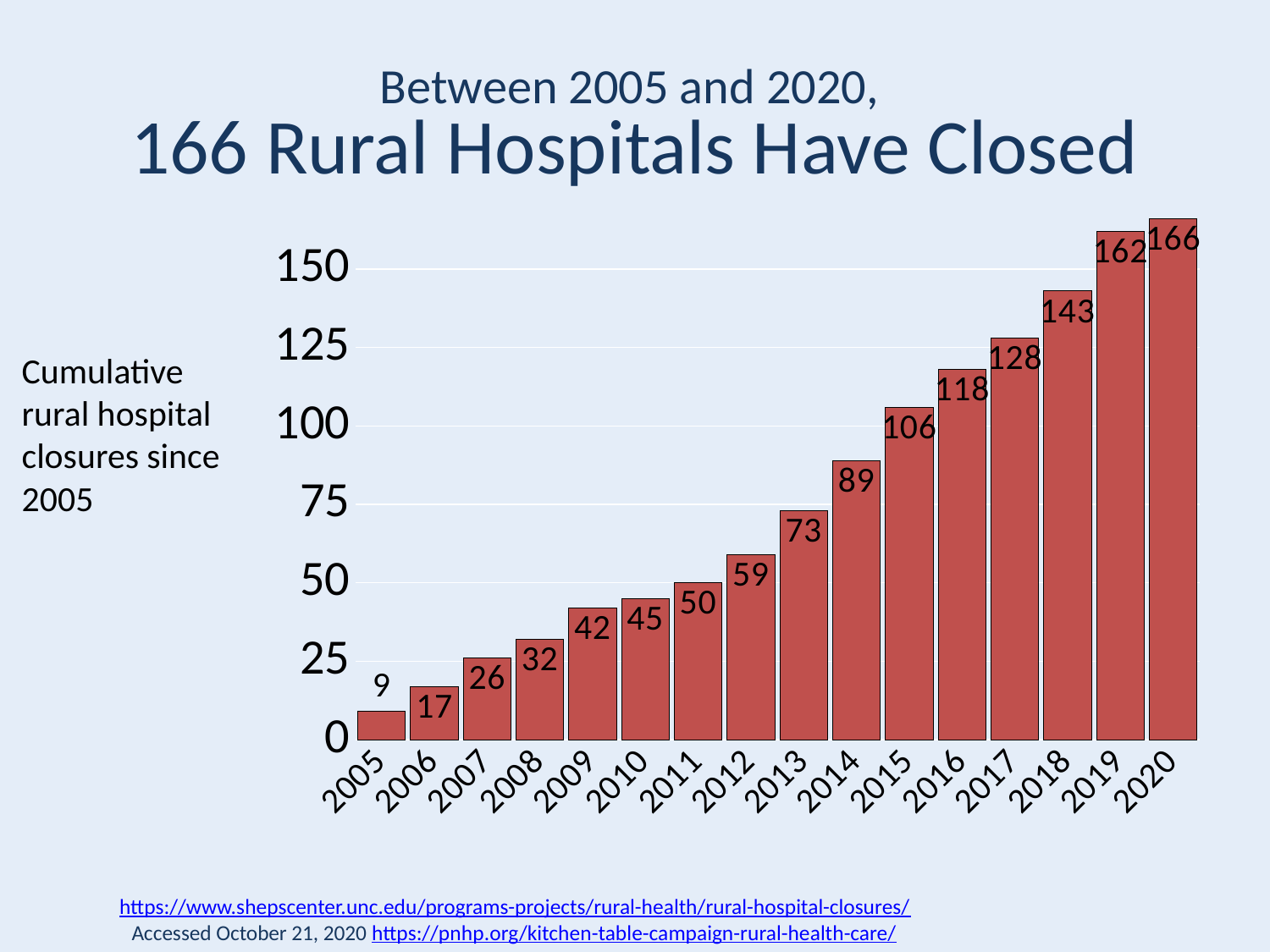
Is the value for 2016 greater or less than 100? greater What is the difference between the values for 2020 and 2019? 4 Which year has the lowest value on the chart? 2005 What is the cumulative number of rural hospital closures shown for 2013? 73 What is the difference between the values for 2015 and 2010? 61 What value is shown for 2005? 9 What is the value shown for 2017? 128 What kind of chart is shown on the slide? bar chart How many years are shown on the x axis? 16 Which is larger, the value for 2012 or the value for 2014? 2014 Do the values rise or fall from 2005 to 2020? rise Which year has the highest value on the chart? 2020